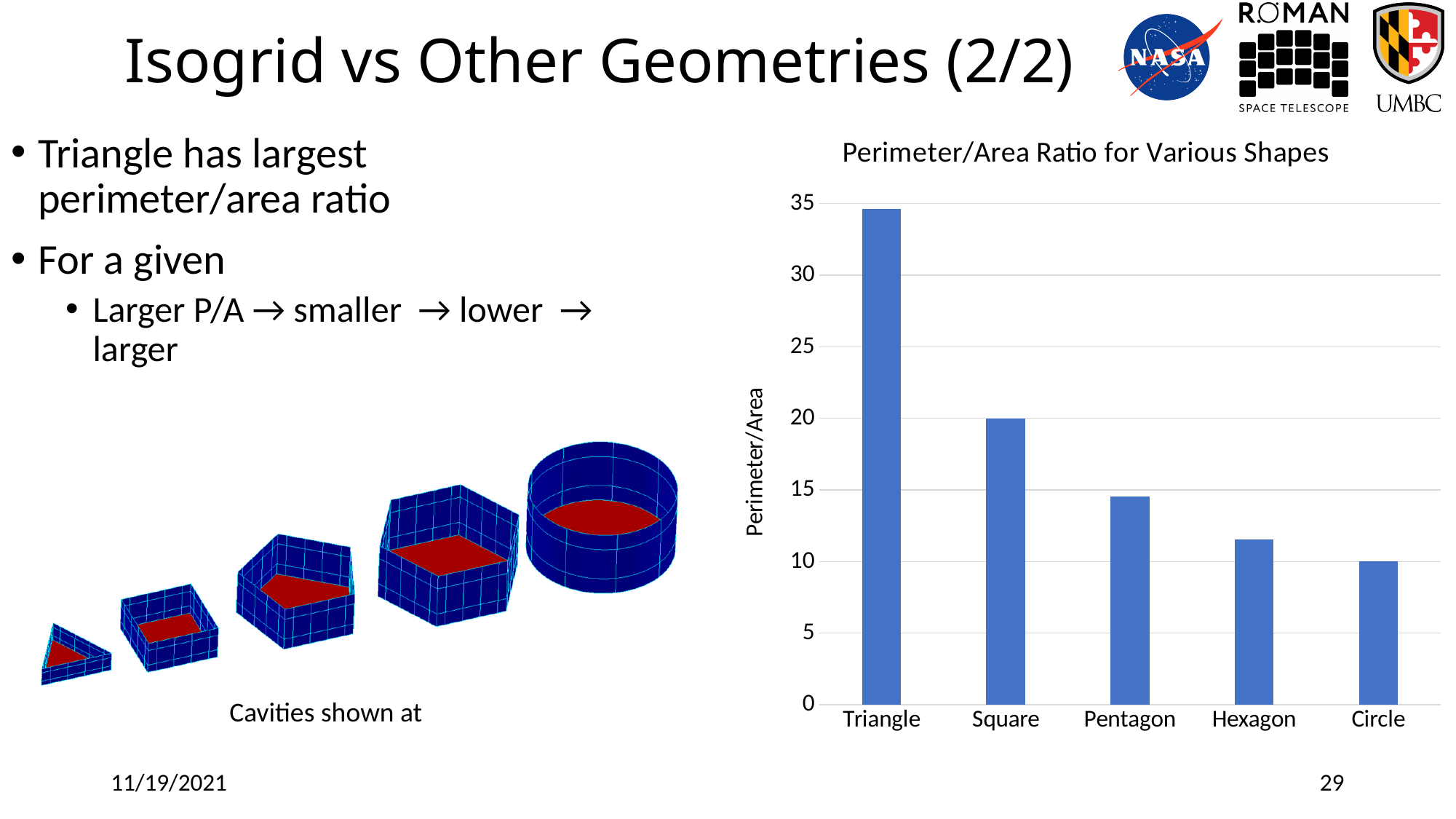
Which has a larger perimeter/area ratio, Square or Pentagon? Square How many shapes are plotted on the chart? 5 What kind of chart is shown on the slide? bar chart Is the perimeter/area ratio for Pentagon greater or less than 15? less Is the perimeter/area ratio for Triangle greater or less than 30? greater Which shape has the lowest perimeter/area ratio? Circle What is the label of the vertical axis of the chart? Perimeter/Area Is the perimeter/area ratio for Hexagon greater or less than 10? greater Do the perimeter/area ratios rise or fall from Triangle to Circle along the x axis? fall Which has a larger perimeter/area ratio, Hexagon or Circle? Hexagon What is the title of the chart? Perimeter/Area Ratio for Various Shapes Which shape has the highest perimeter/area ratio? Triangle